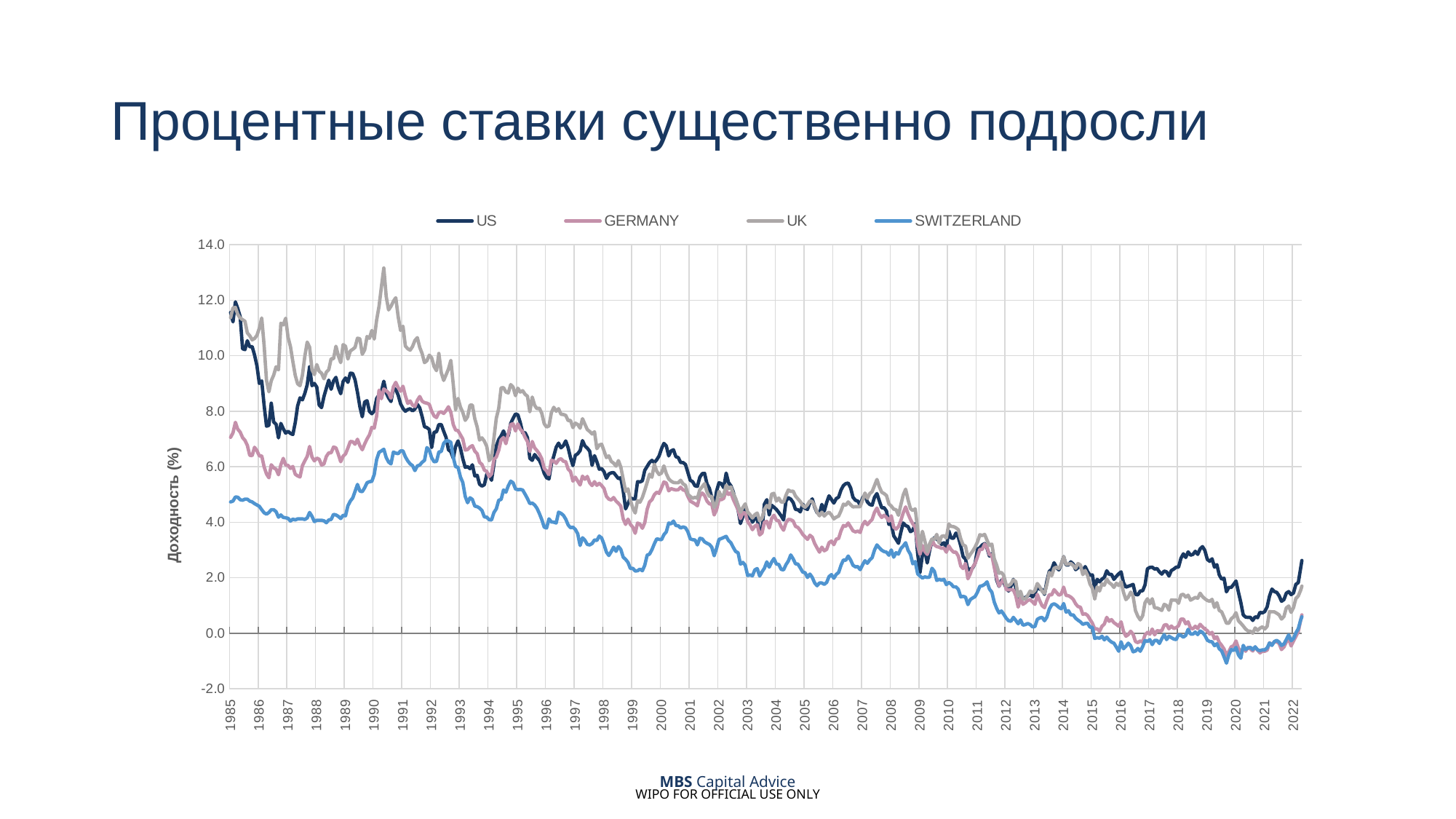
What kind of chart is shown on the slide? line chart Which series has the lowest value in 1985? SWITZERLAND Is the value for SWITZERLAND in 1985 greater or less than 6.0? less Is the value for US at the end of 2022 greater or less than 2.0? greater Overall, do the values rise or fall from 1985 to 2022? fall How many series does the legend list? 4 Which series reaches the highest value anywhere on the chart? UK In 1985, which is higher, US or SWITZERLAND? US Is the value for SWITZERLAND at the start of 2020 greater or less than 0.0? less What is the label of the vertical axis? Доходность (%) Which series are listed in the legend? US, GERMANY, UK, SWITZERLAND